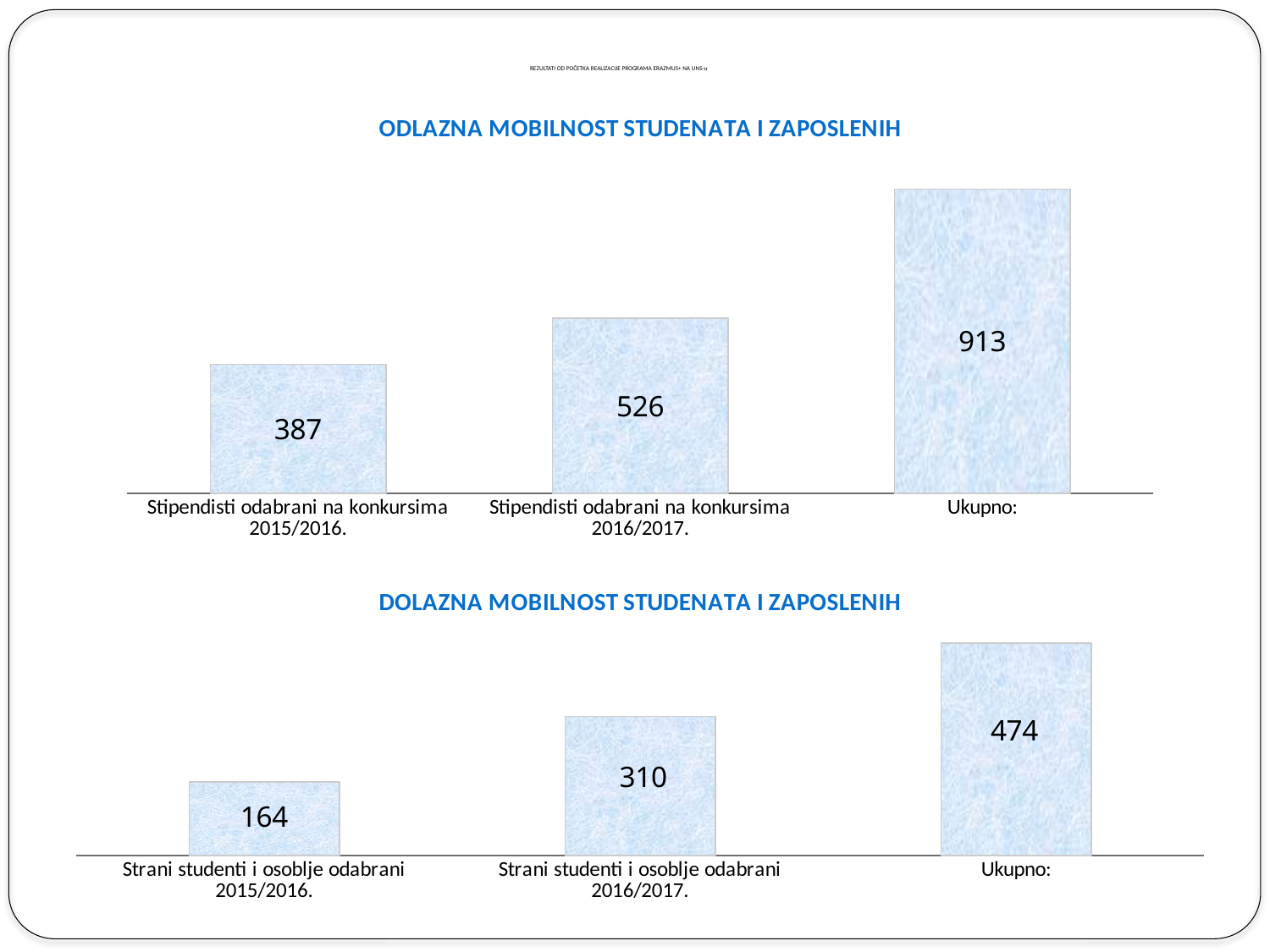
In the 'DOLAZNA MOBILNOST STUDENATA I ZAPOSLENIH' chart, what is the value for 'Strani studenti i osoblje odabrani 2016/2017.'? 310 How many bars are shown in the 'DOLAZNA MOBILNOST STUDENATA I ZAPOSLENIH' chart? 3 What type of chart is the 'ODLAZNA MOBILNOST STUDENATA I ZAPOSLENIH' chart? Bar chart In the 'ODLAZNA MOBILNOST STUDENATA I ZAPOSLENIH' chart, what is the value for 'Ukupno:'? 913 In the 'ODLAZNA MOBILNOST STUDENATA I ZAPOSLENIH' chart, which category has the lowest value? Stipendisti odabrani na konkursima 2015/2016. In the 'ODLAZNA MOBILNOST STUDENATA I ZAPOSLENIH' chart, what is the value for 'Stipendisti odabrani na konkursima 2015/2016.'? 387 In the 'ODLAZNA MOBILNOST STUDENATA I ZAPOSLENIH' chart, what is the value for 'Stipendisti odabrani na konkursima 2016/2017.'? 526 In the 'DOLAZNA MOBILNOST STUDENATA I ZAPOSLENIH' chart, what is the value for 'Strani studenti i osoblje odabrani 2015/2016.'? 164 In the 'DOLAZNA MOBILNOST STUDENATA I ZAPOSLENIH' chart, which category has the highest value? Ukupno: In the 'ODLAZNA MOBILNOST STUDENATA I ZAPOSLENIH' chart, what is the difference between the 2016/2017 value and the 2015/2016 value? 139 In the 'DOLAZNA MOBILNOST STUDENATA I ZAPOSLENIH' chart, what is the value for 'Ukupno:'? 474 In the 'DOLAZNA MOBILNOST STUDENATA I ZAPOSLENIH' chart, what is the difference between the 2016/2017 value and the 2015/2016 value? 146